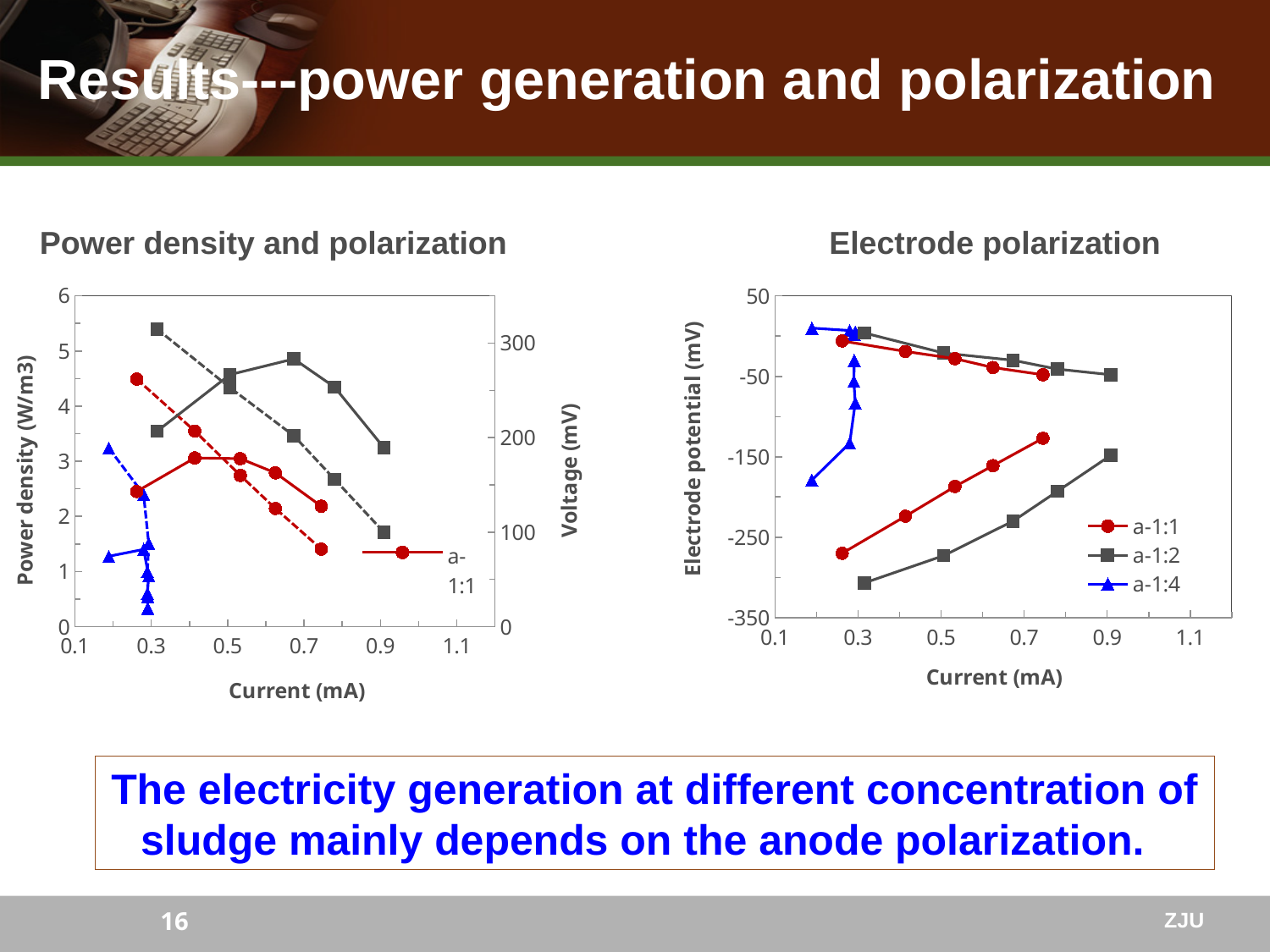
What is the y-axis title of the 'Electrode polarization' chart? Electrode potential (mV) In the 'Power density and polarization' chart, does the dashed black-square voltage series rise or fall as current increases? fall What is the right-hand y-axis title of the 'Power density and polarization' chart? Voltage (mV) How many series does the legend of the 'Electrode polarization' chart list? 3 In the 'Power density and polarization' chart, is the highest power density of the blue-triangle series greater or less than 2 W/m3? less In the 'Power density and polarization' chart, is the highest power density of the red-circle series greater or less than 4 W/m3? less In the 'Electrode polarization' chart, does the upper a-1:1 curve rise or fall as current increases? fall What kind of chart is the 'Electrode polarization' chart? line chart In the 'Power density and polarization' chart, is the voltage of the black-square series at about 0.3 mA greater or less than 300 mV? greater What is the x-axis title of the 'Electrode polarization' chart? Current (mA) In the 'Electrode polarization' chart, does the lower a-1:2 curve rise or fall as current increases? rise